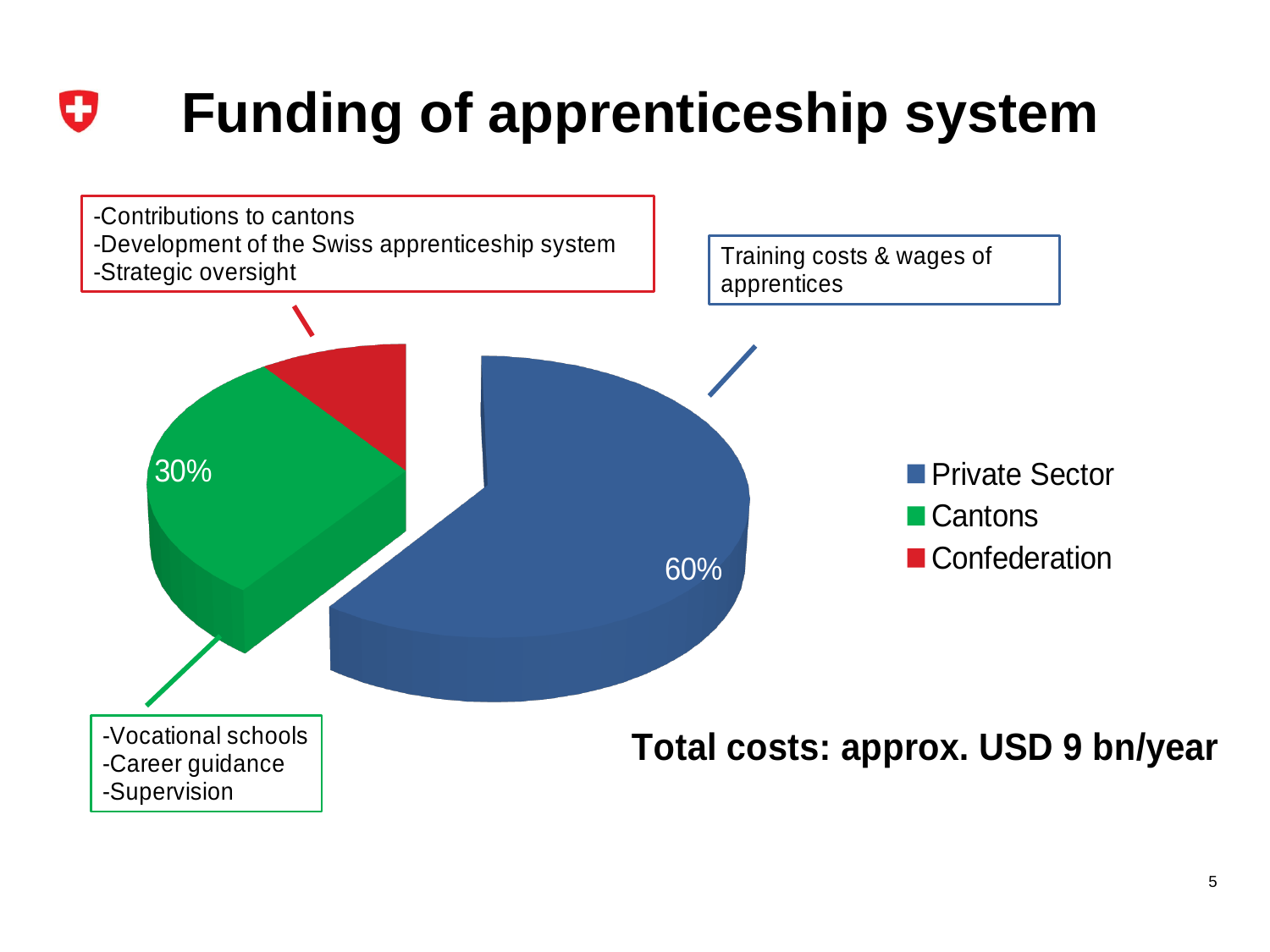
What share of the pie does the Private Sector slice represent? 60% Which is larger, the Private Sector slice or the Cantons slice? Private Sector What colour is the Confederation slice in the pie chart? Red What share of the pie does the Cantons slice represent? 30% By how many percentage points does the Private Sector share exceed the Cantons share? 30 percentage points Which is larger, the Cantons slice or the Confederation slice? Cantons How many categories does the legend list? 3 Which category has the largest slice of the pie? Private Sector What is the title of the slide containing the pie chart? Funding of apprenticeship system Which category has the smallest slice of the pie? Confederation What kind of chart is shown on the slide? Pie chart